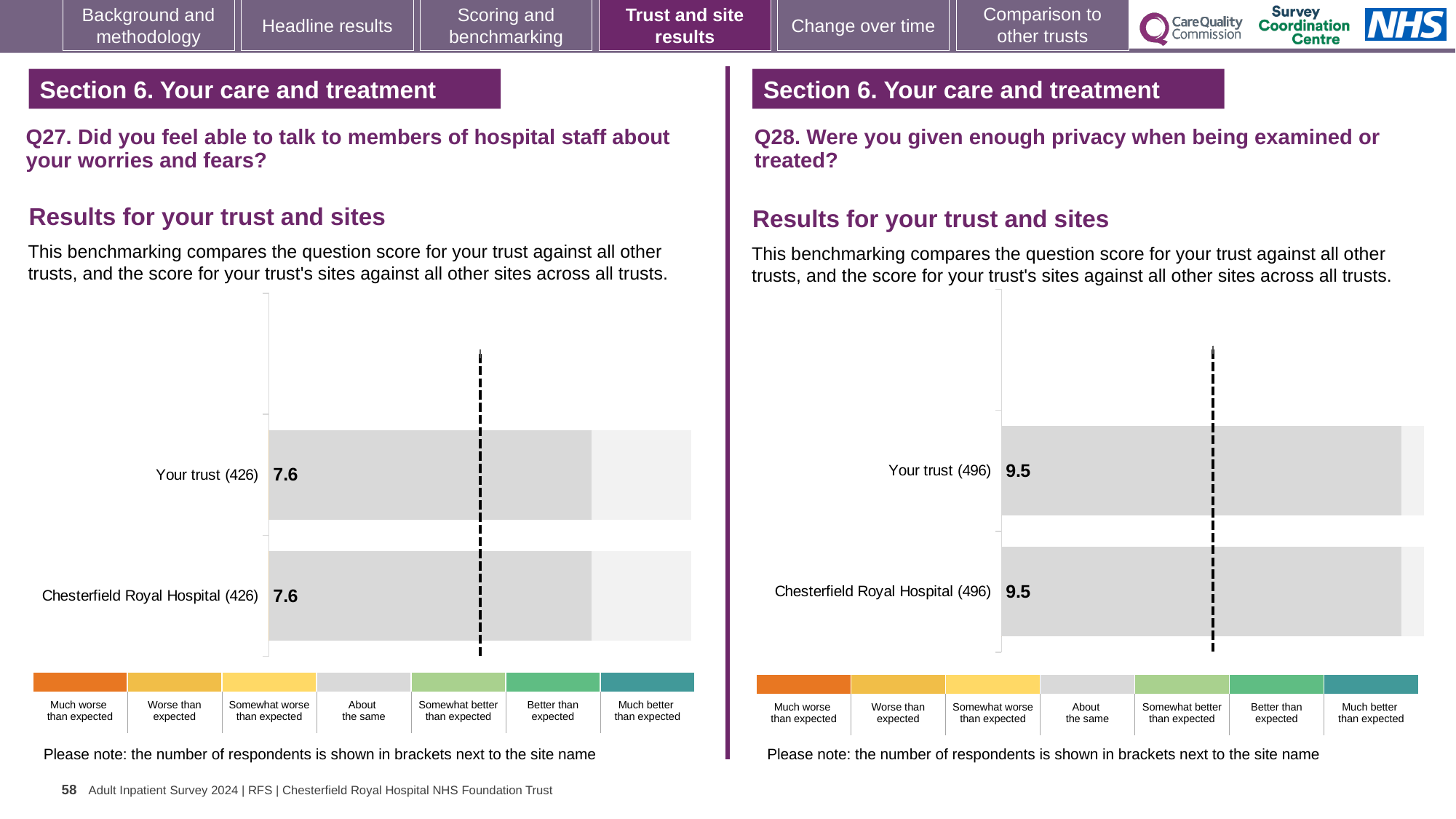
In the Q27 chart on the left, what is the score for Chesterfield Royal Hospital? 7.6 How many bars are plotted in the Q28 chart on the right? 2 In the Q27 chart on the left, how many respondents are shown in brackets next to Your trust? 426 In the Q27 chart on the left, what is the score for Your trust? 7.6 What kind of chart is the Q27 chart on the left? Bar chart Is the score for Your trust in the Q28 chart on the right larger or smaller than the score for Your trust in the Q27 chart on the left? Larger In the Q28 chart on the right, what is the score for Chesterfield Royal Hospital? 9.5 In the Q28 chart on the right, how many respondents are shown in brackets next to Chesterfield Royal Hospital? 496 In the Q28 chart on the right, what is the difference between the score for Your trust and the score for Chesterfield Royal Hospital? 0 In the Q28 chart on the right, what is the score for Your trust? 9.5 In the Q27 chart on the left, what is the difference between the score for Your trust and the score for Chesterfield Royal Hospital? 0 How many bars are plotted in the Q27 chart on the left? 2